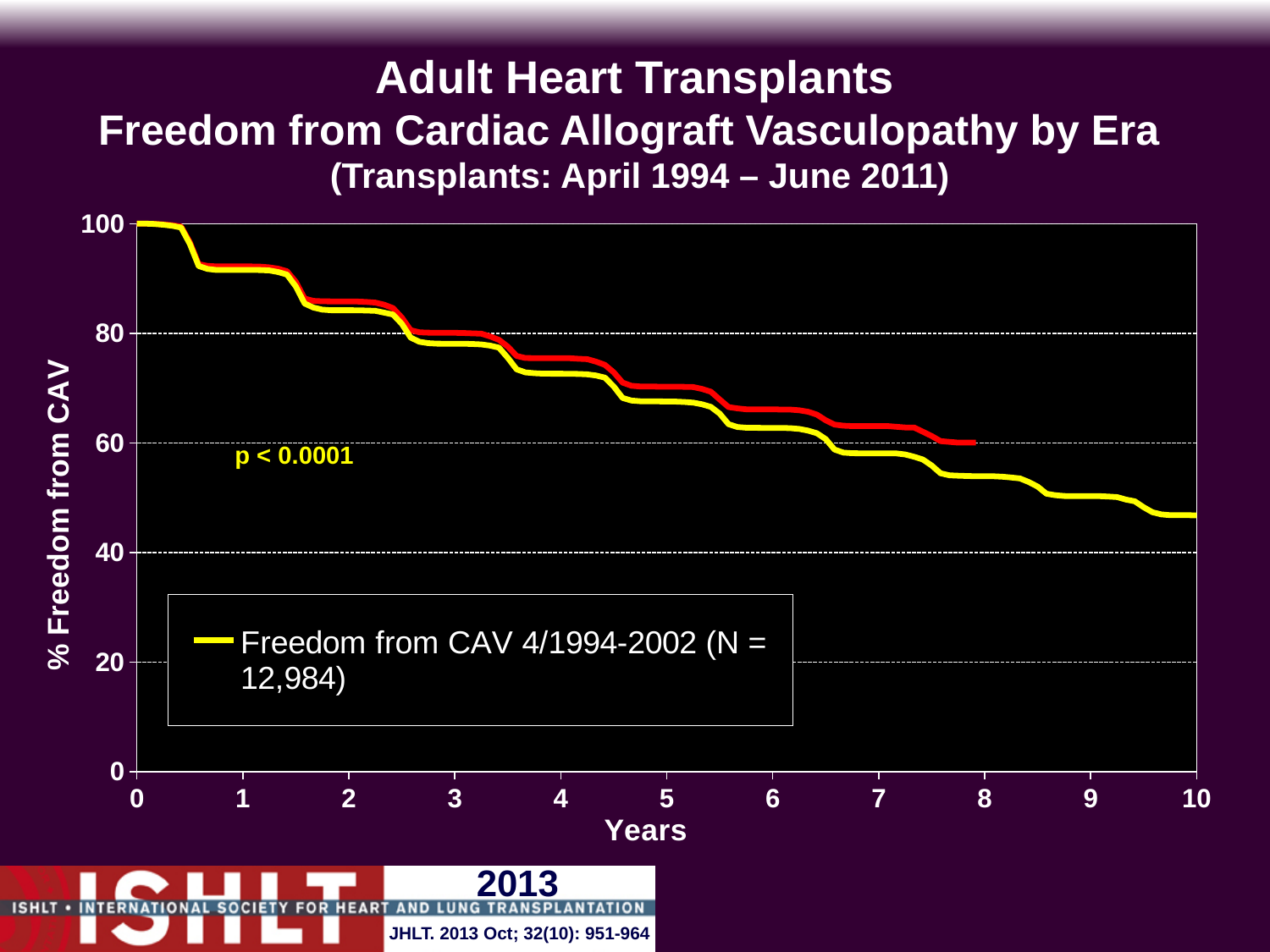
What kind of chart is shown on the slide? line chart Is the value of the yellow line at 5 years greater or less than 60? greater Is the value of the red line at 3 years greater or less than 60? greater At 6 years, which line has the higher value, the red line or the yellow line? red line What is the label of the series shown in the legend? Freedom from CAV 4/1994-2002 (N = 12,984) Do the values of the yellow line rise or fall as years increase? fall What is the label of the y axis? % Freedom from CAV How many series does the legend list? 1 Which line extends further along the x axis, the red line or the yellow line? yellow line What is the title of the chart on the slide? Adult Heart Transplants Freedom from Cardiac Allograft Vasculopathy by Era (Transplants: April 1994 – June 2011) Is the value of the yellow line at 10 years greater or less than 60? less